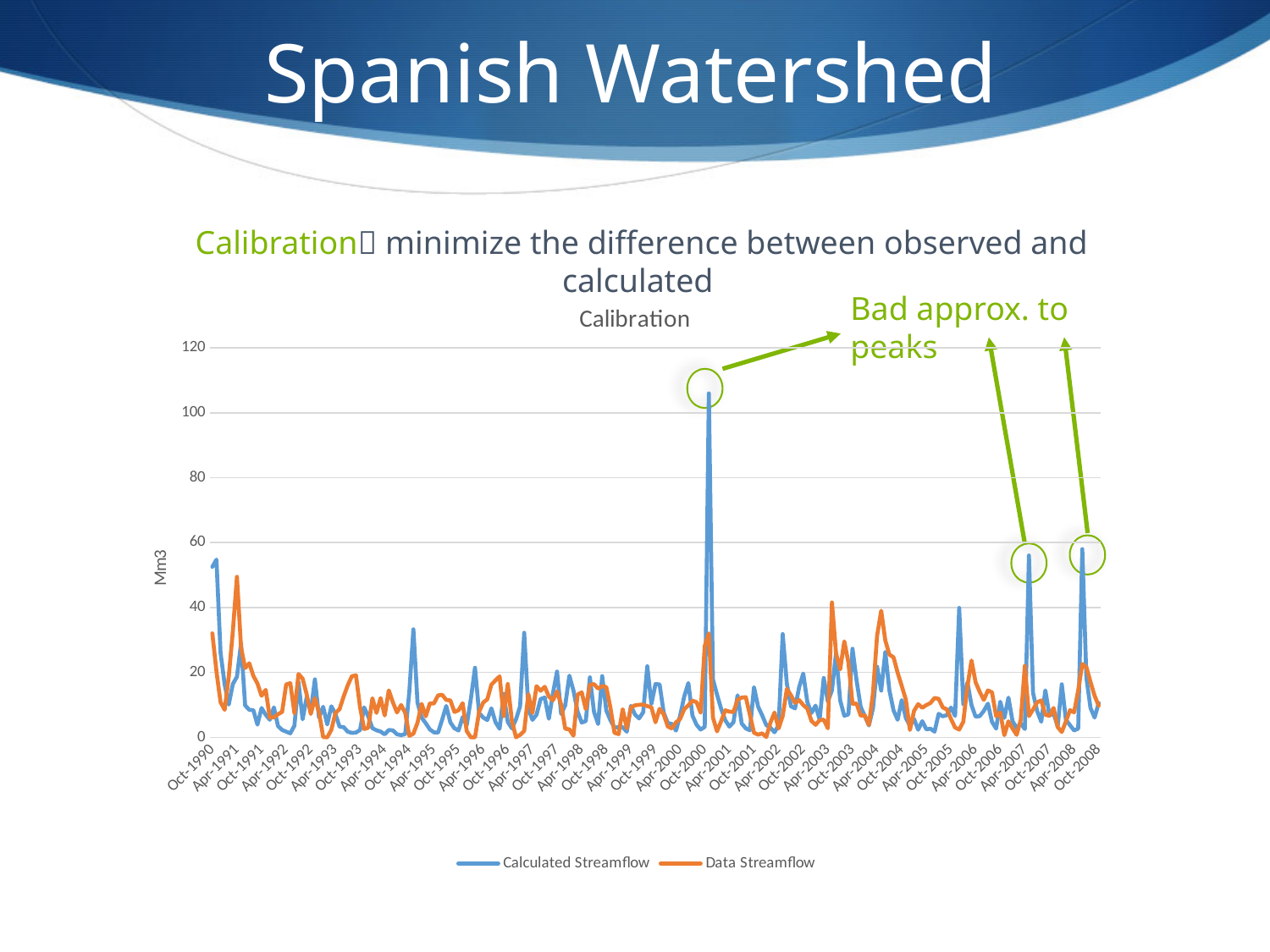
What are the two series named in the legend? Calculated Streamflow and Data Streamflow How many series does the legend list? 2 Is the highest peak of the Data Streamflow series greater or less than 100? less Which series reaches the higher maximum value, Calculated Streamflow or Data Streamflow? Calculated Streamflow What kind of chart is shown on the slide? line chart Is the Data Streamflow peak near Apr-1991 greater or less than 60? less Is the Calculated Streamflow value at Oct-1990 greater or less than 40? greater At the large spike near Oct-2000, which series is higher? Calculated Streamflow Near which x-axis label does the Calculated Streamflow series reach its highest value? Oct-2000 What is the title of the chart? Calibration